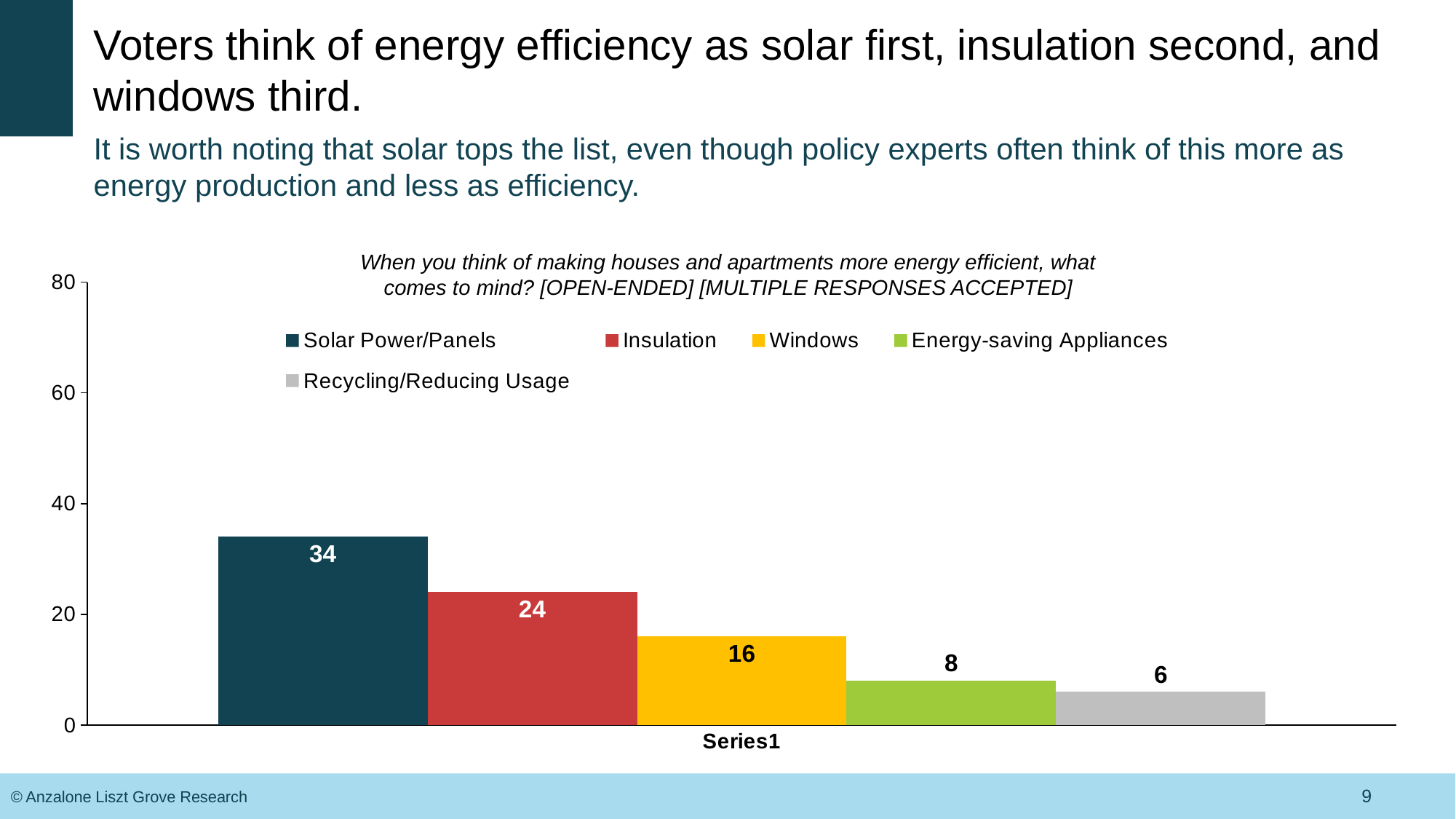
Which category has the lowest value? Recycling/Reducing Usage Which category has the highest value? Solar Power/Panels What is the value for Insulation? 24 What is the value for Solar Power/Panels? 34 What is the value for Recycling/Reducing Usage? 6 What colour is the bar for Windows? yellow What is the difference between the values for Solar Power/Panels and Insulation? 10 How many series does the legend list? 5 Which is larger, the value for Windows or the value for Energy-saving Appliances? Windows What is the value for Windows? 16 Is the value for Insulation greater or less than 20? greater What kind of chart is shown on the slide? bar chart